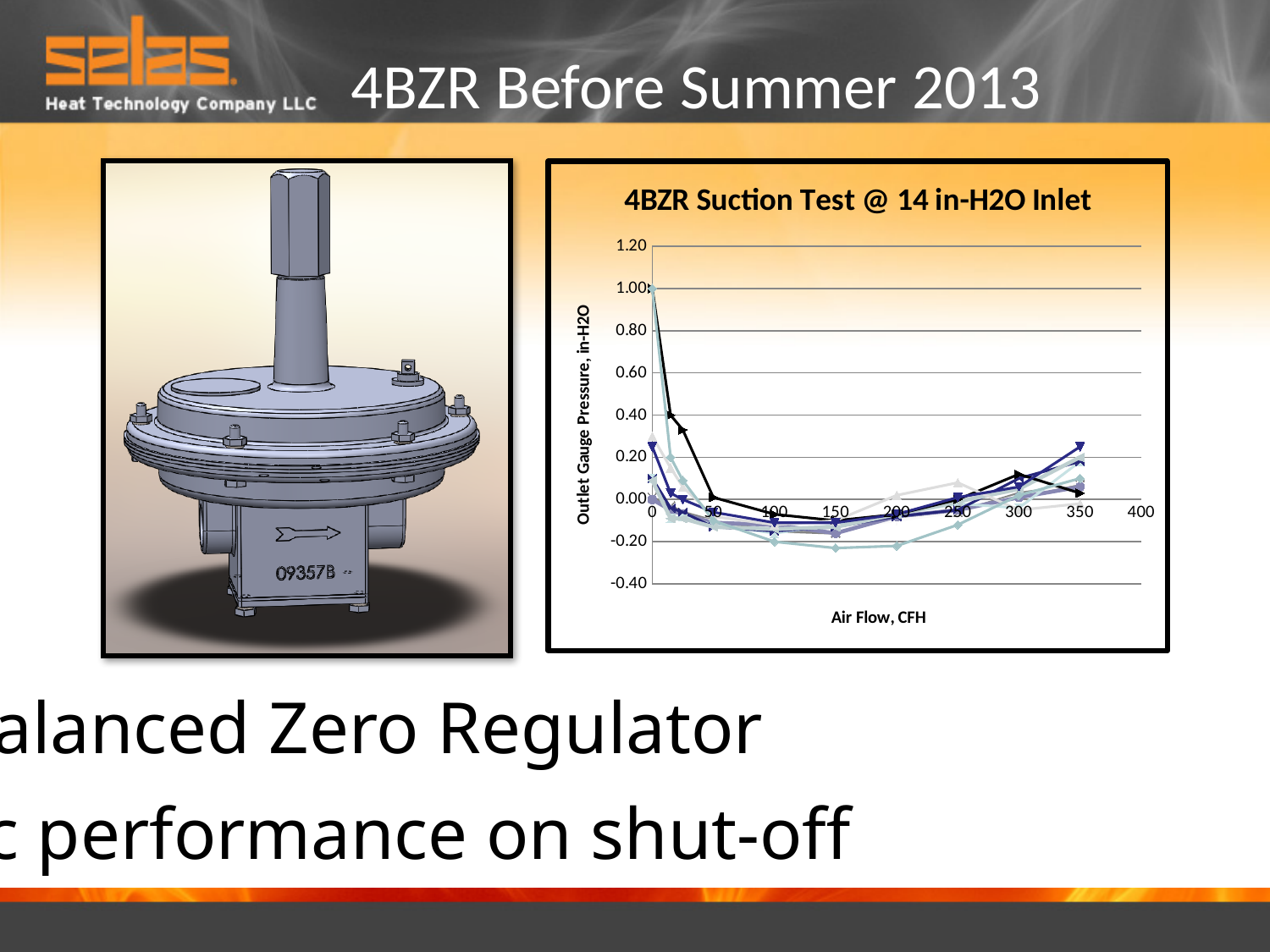
Is the highest plotted value on the chart greater or less than 1.20? less Between 150 and 350 CFH, do the plotted outlet gauge pressure values generally rise or fall? rise At 150 CFH, are the plotted outlet gauge pressure values greater or less than 0.00? less What kind of chart is shown on the slide? line chart What is the title of the chart on the slide? 4BZR Suction Test @ 14 in-H2O Inlet At 350 CFH, are the plotted outlet gauge pressure values greater or less than 0.40? less Between 0 and 150 CFH, do the plotted outlet gauge pressure values rise or fall? fall What is the label of the x axis of the chart? Air Flow, CFH